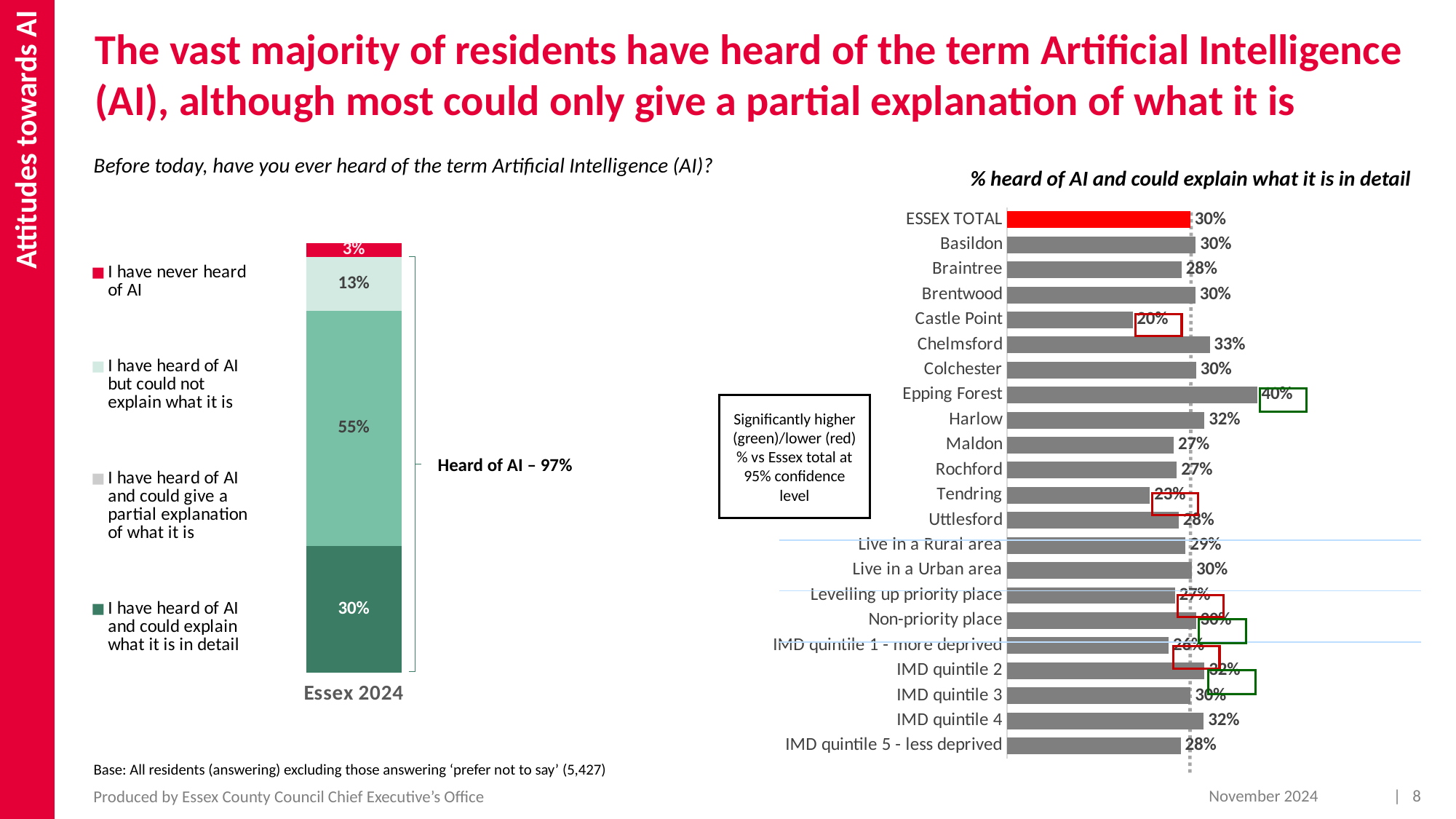
On the left stacked bar chart (Essex 2024), what is the combined percentage of residents who have heard of AI? 97% On the right chart (% heard of AI and could explain what it is in detail), what is the difference between Chelmsford and Tendring? 10% On the right chart (% heard of AI and could explain what it is in detail), what is the value for Epping Forest? 40% On the right chart (% heard of AI and could explain what it is in detail), which area has the lowest value? Castle Point What type of chart is the right chart (% heard of AI and could explain what it is in detail)? Bar chart On the left stacked bar chart (Essex 2024), what percentage of residents have never heard of AI? 3% On the right chart (% heard of AI and could explain what it is in detail), which area has the highest value? Epping Forest On the right chart (% heard of AI and could explain what it is in detail), what is the value for ESSEX TOTAL? 30% On the right chart (% heard of AI and could explain what it is in detail), which is larger, Harlow or Maldon? Harlow On the left stacked bar chart (Essex 2024), what percentage of residents have heard of AI and could explain what it is in detail? 30% On the left stacked bar chart (Essex 2024), what percentage of residents have heard of AI and could give a partial explanation of what it is? 55% On the left stacked bar chart (Essex 2024), how many series does the legend list? 4